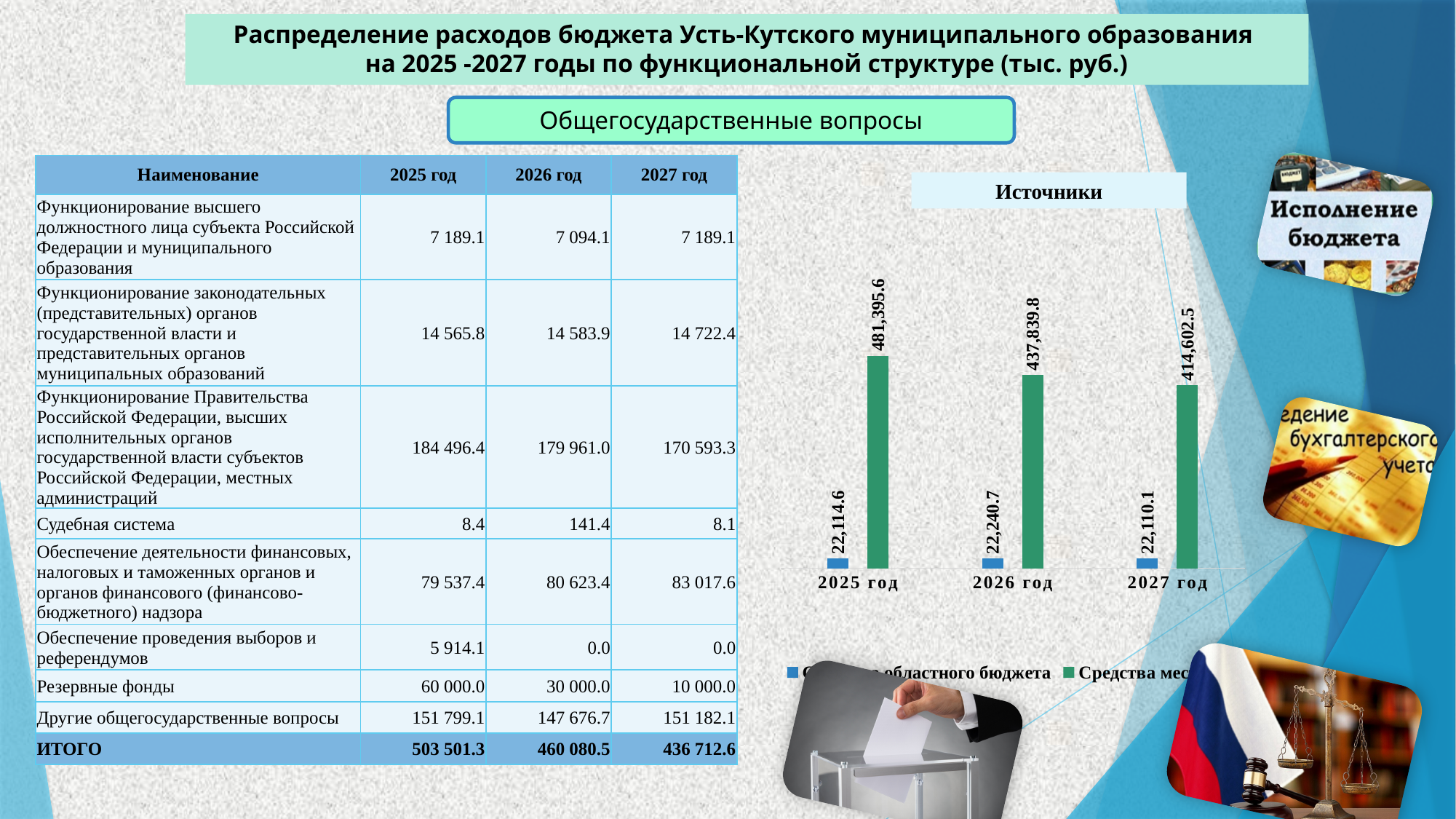
In the "Источники" chart, what is the value of the green bar for 2027 год? 414,602.5 In the "Источники" chart, what is the value of the blue bar for 2026 год? 22,240.7 In the "Источники" chart, what is the value of the green bar for 2025 год? 481,395.6 In the "Источники" chart, what is the value of the blue bar for 2027 год? 22,110.1 In the "Источники" chart, which year has the lowest green bar? 2027 год In the "Источники" chart, how many series does the legend list? 2 In the "Источники" chart, what is the value of the blue bar for 2025 год? 22,114.6 What kind of chart is shown under the heading "Источники"? bar chart In the "Источники" chart, how many year categories are shown on the x axis? 3 In the "Источники" chart, which year has the highest green bar? 2025 год In the "Источники" chart, what is the value of the green bar for 2026 год? 437,839.8 In the "Источники" chart, how do the green bar values change from 2025 год to 2027 год? They fall